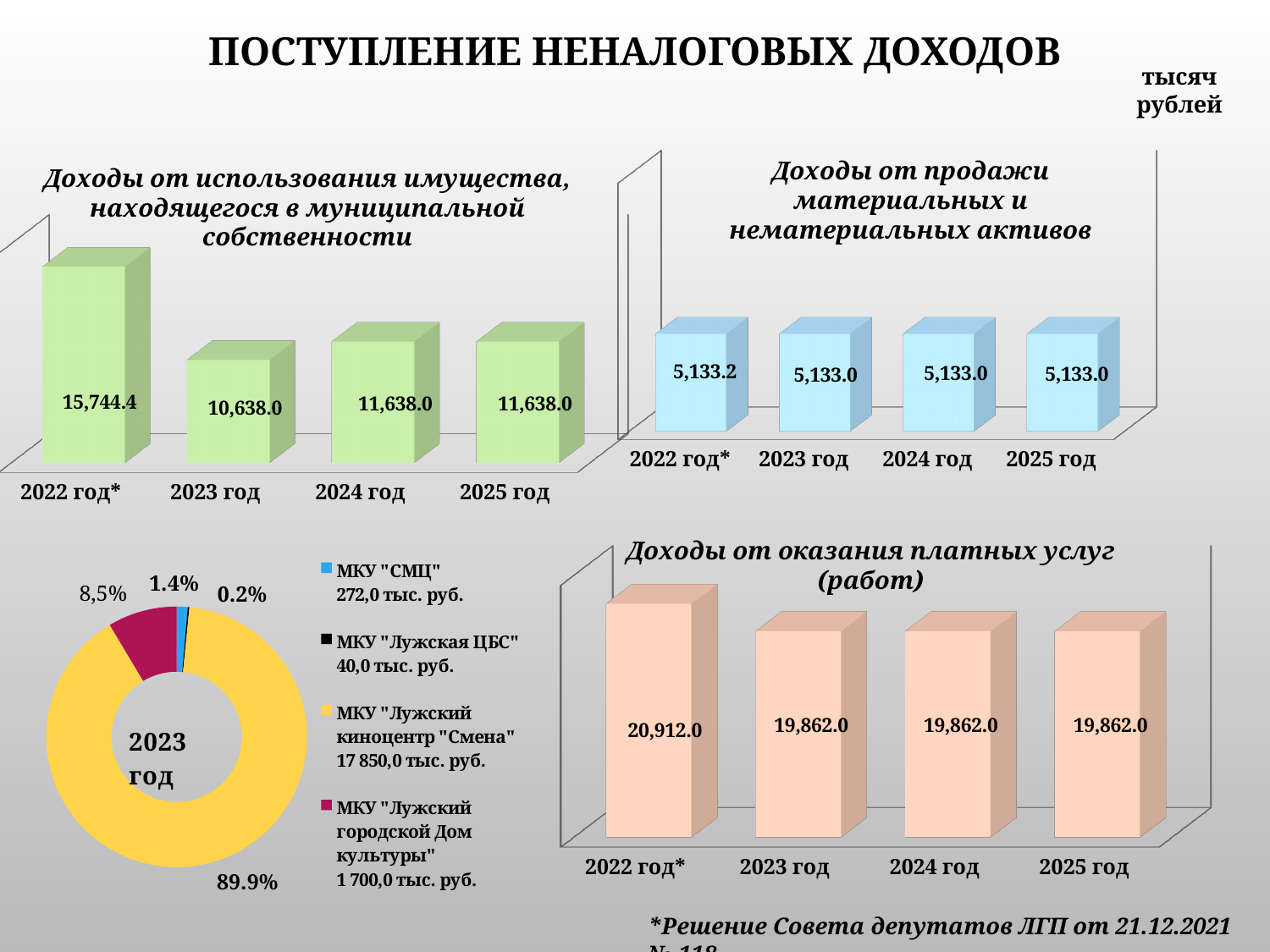
In the chart 'Доходы от оказания платных услуг (работ)', what is the difference between the 2022 год* value and the 2025 год value? 1,050.0 In the chart 'Доходы от оказания платных услуг (работ)', which year has the highest value? 2022 год* In the chart 'Доходы от оказания платных услуг (работ)', do the values rise or fall from 2022 год* to 2023 год? fall In the chart 'Доходы от продажи материальных и нематериальных активов', what is the value for 2022 год*? 5,133.2 In the chart 'Доходы от продажи материальных и нематериальных активов', how many years are shown? 4 In the chart 'Доходы от использования имущества, находящегося в муниципальной собственности', what is the value for 2022 год*? 15,744.4 In the chart 'Доходы от использования имущества, находящегося в муниципальной собственности', which year has the lowest value? 2023 год In the chart 'Доходы от использования имущества, находящегося в муниципальной собственности', what is the difference between the 2022 год* value and the 2023 год value? 5,106.4 In the chart 'Доходы от оказания платных услуг (работ)', what is the value for 2024 год? 19,862.0 In the donut chart for 2023 год at the bottom left, what amount is listed in the legend for МКУ "Лужский городской Дом культуры"? 1 700,0 тыс. руб. In the donut chart for 2023 год at the bottom left, what share does МКУ "Лужский киноцентр "Смена"" have? 89.9% What type of chart is the bottom-left chart labelled 2023 год? donut (pie) chart